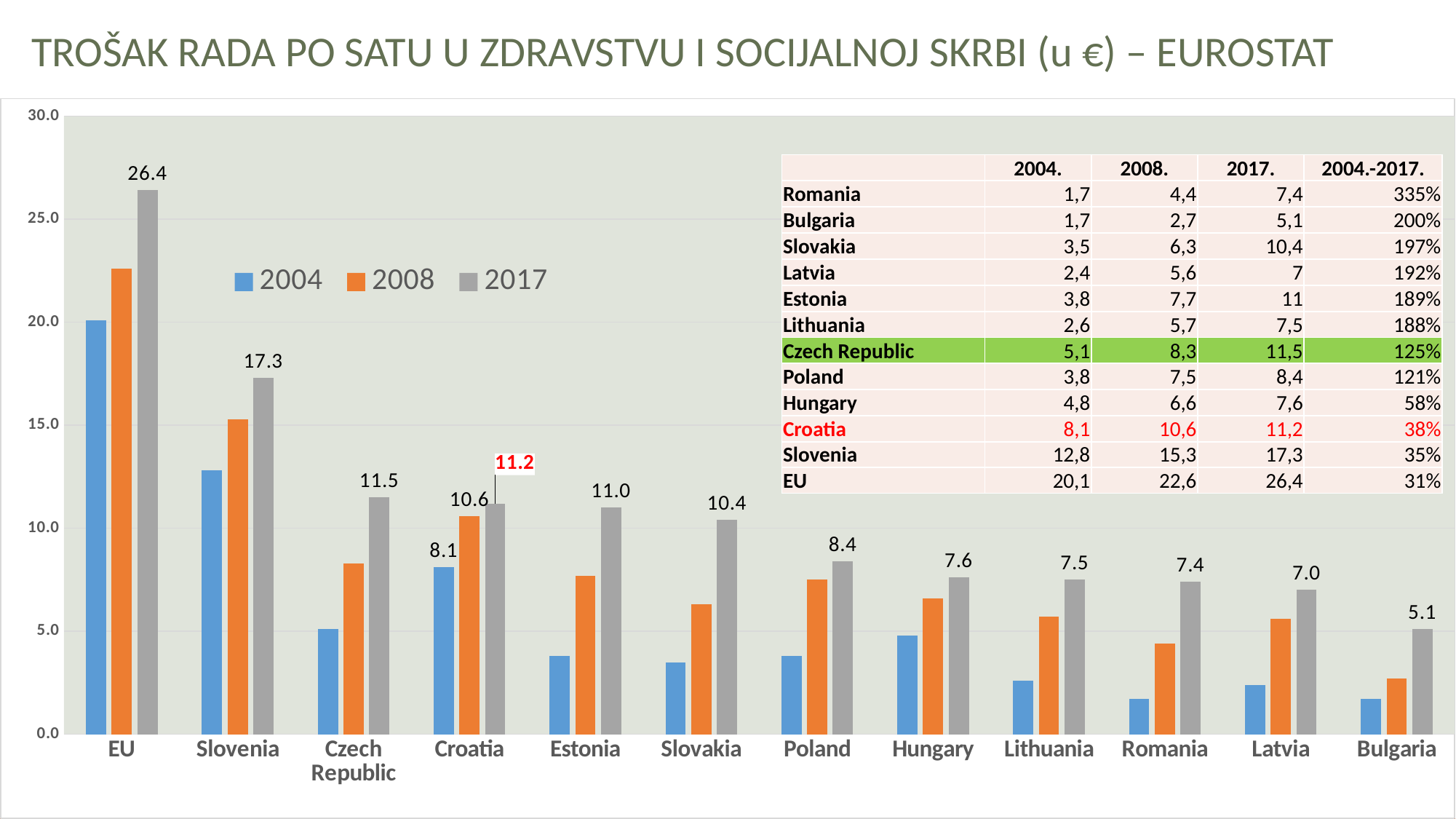
What is the 2008 value for Croatia? 10.6 How many categories are shown on the x axis? 12 What is the 2017 value for the EU? 26.4 Do the 2017 values generally rise or fall from left to right along the x axis? fall Which is larger, the 2017 value for Estonia or the 2017 value for Slovakia? Estonia What is the 2017 value for Slovenia? 17.3 What is the difference between the 2017 values for Czech Republic and Croatia? 0.3 Which category has the highest 2017 value? EU Which category has the lowest 2017 value? Bulgaria What kind of chart is shown? bar chart How many series does the legend list? 3 Is the 2004 value for Slovenia greater or less than 10.0? greater